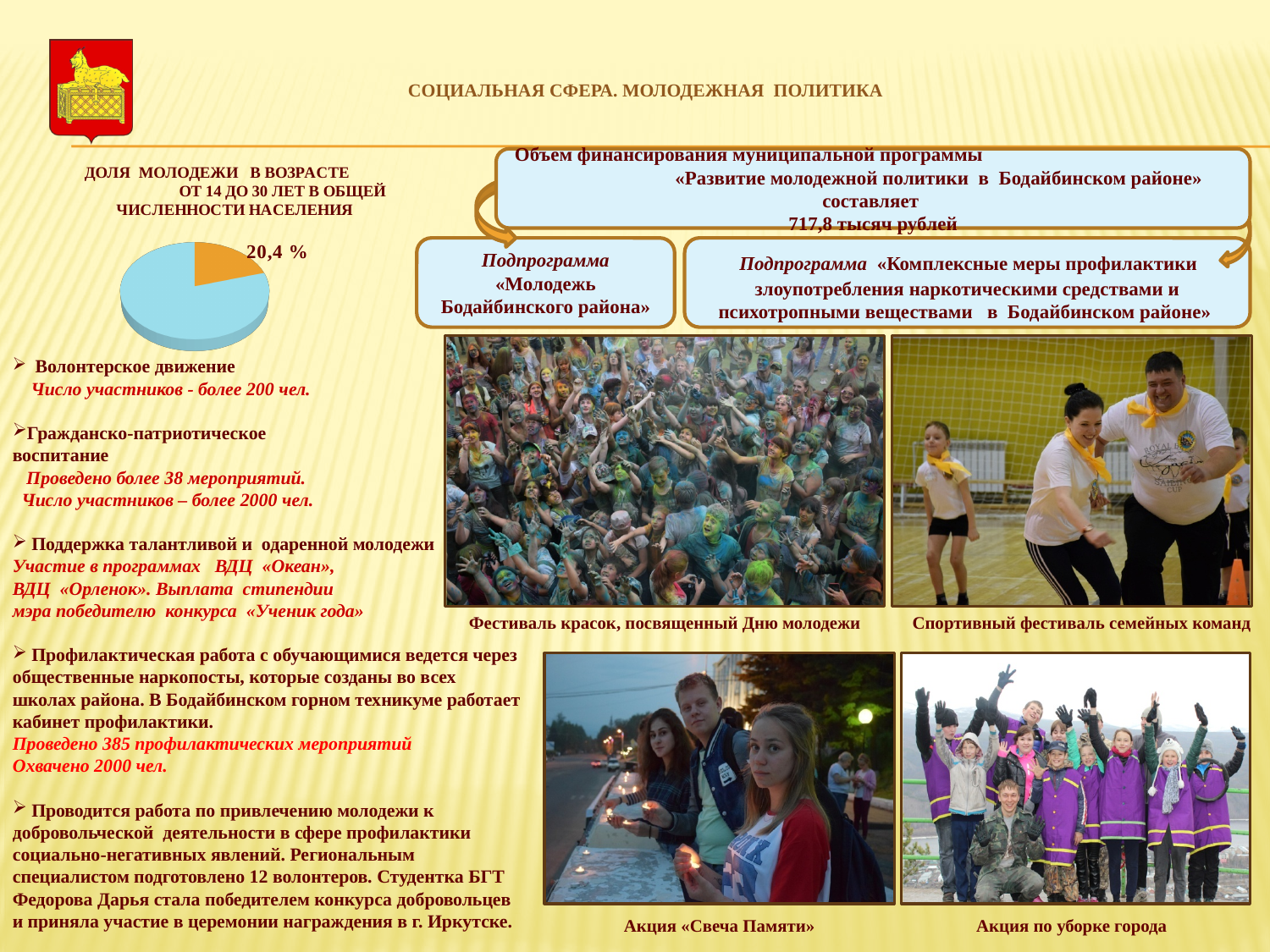
What is the title of the pie chart? ДОЛЯ МОЛОДЕЖИ В ВОЗРАСТЕ ОТ 14 ДО 30 ЛЕТ В ОБЩЕЙ ЧИСЛЕННОСТИ НАСЕЛЕНИЯ What kind of chart is shown on the slide? pie chart What value is printed as the data label on the pie chart? 20,4 % What colour is the slice labelled 20,4 % in the pie chart? orange Which slice of the pie chart is larger, the orange slice or the light blue slice? the light blue slice Is the slice labelled 20,4 % the smallest slice of the pie chart? yes What share of the total population is youth aged 14 to 30, according to the pie chart? 20,4 % How many slices does the pie chart have? 2